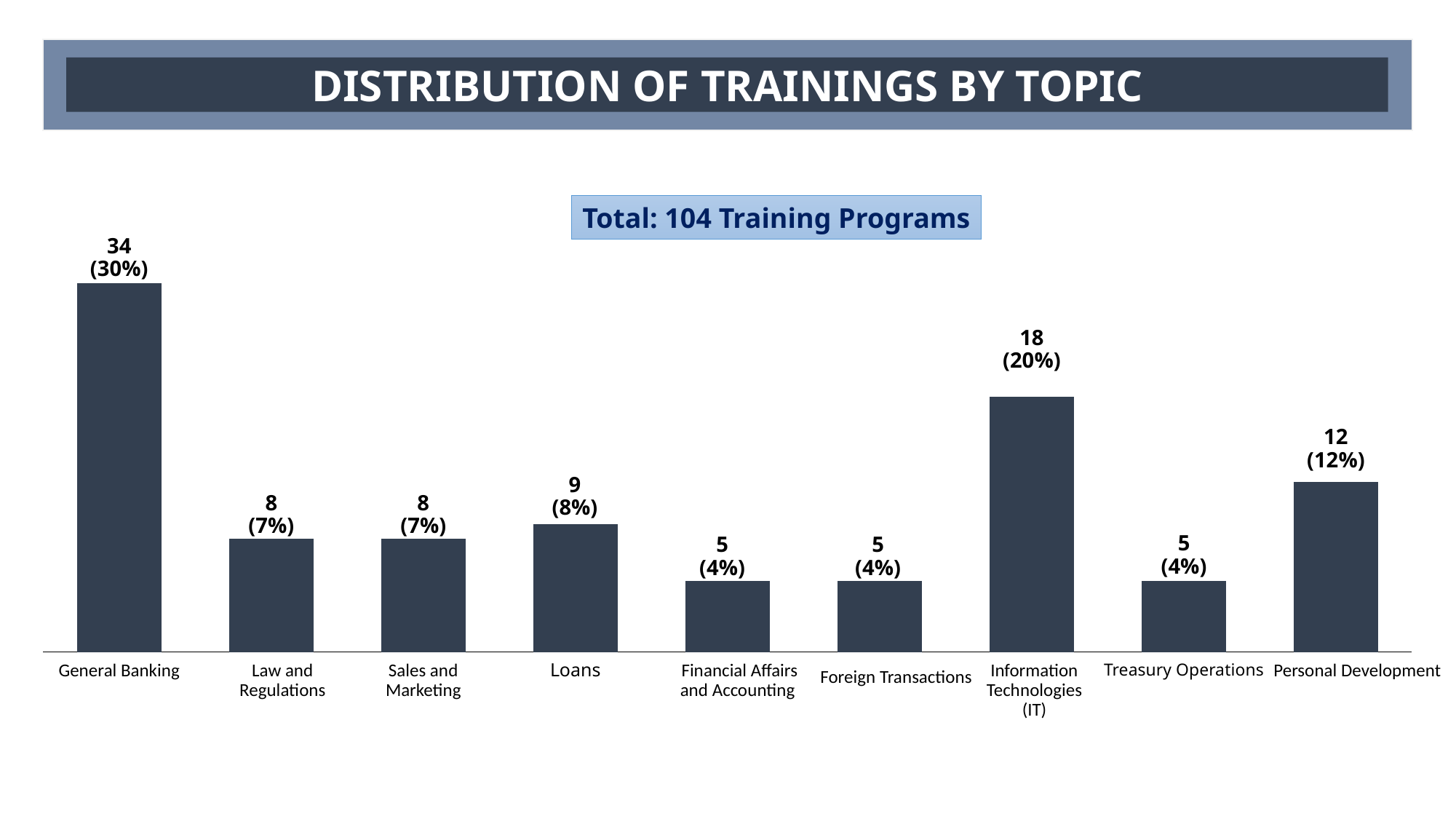
What is the difference in training programs between Personal Development and Treasury Operations? 7 How many topic categories are shown on the chart? 9 How many training programs are shown for Personal Development? 12 What is the difference in training programs between General Banking and Information Technologies (IT)? 16 What is the title of the slide? DISTRIBUTION OF TRAININGS BY TOPIC Which topic has the highest number of training programs? General Banking How many training programs are shown for General Banking? 34 Which has more training programs, Personal Development or Loans? Personal Development Which has more training programs, Loans or Law and Regulations? Loans What total number of training programs is stated on the slide? 104 What percentage share is shown for Information Technologies (IT)? 20% What kind of chart is shown on the slide? Bar chart